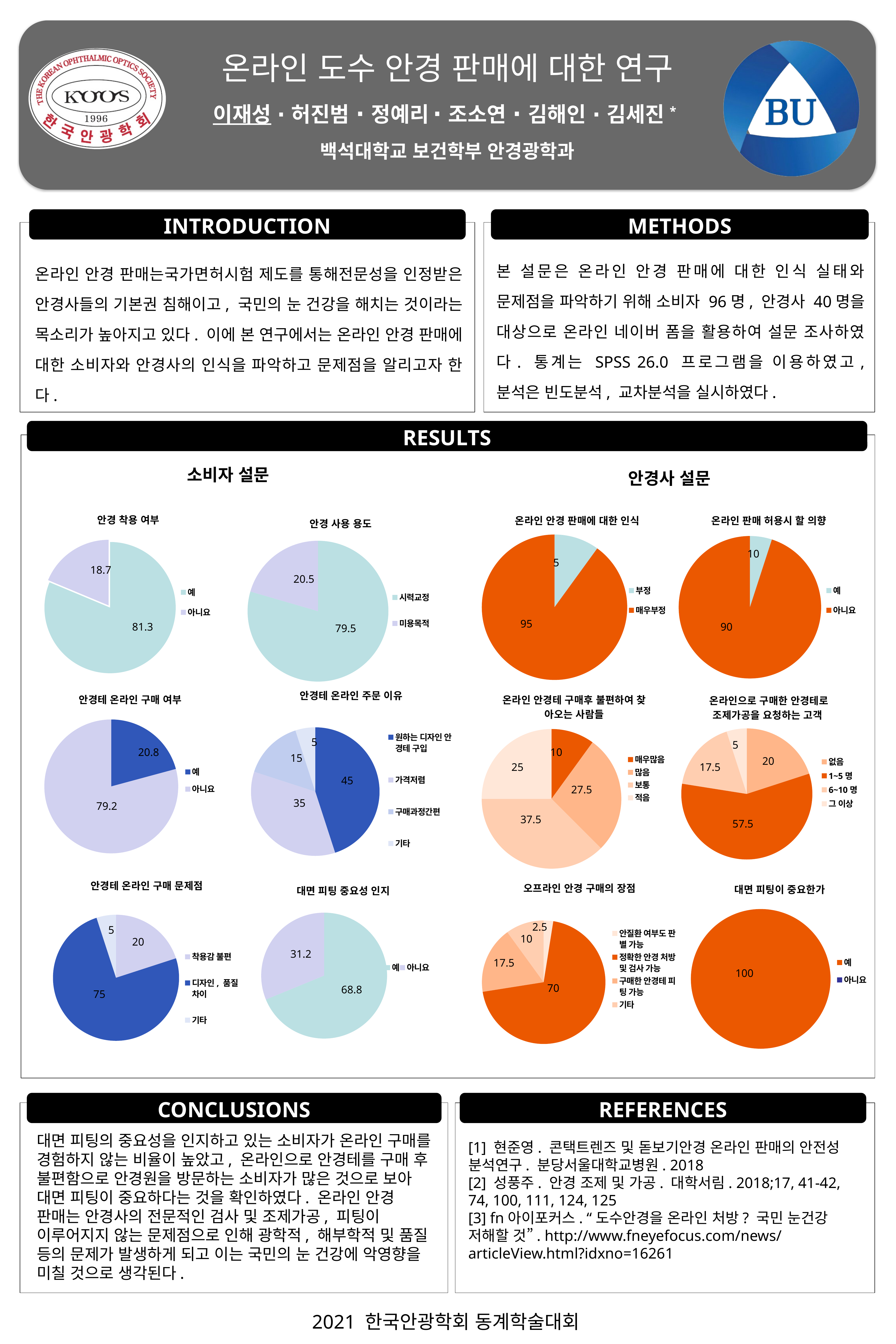
In the '온라인 판매 허용시 할 의향' pie chart, what is the difference between 아니요 and 예? 80 In the '온라인으로 구매한 안경테로 조제가공을 요청하는 고객' pie chart, what is the value for 1~5 명? 57.5 In the '안경테 온라인 구매 여부' pie chart, which is larger, 예 or 아니요? 아니요 In the '오프라인 안경 구매의 장점' pie chart, what is the value for 기타? 10 In the '안경 사용 용도' pie chart, what is the value for 미용목적? 20.5 In the '안경 착용 여부' pie chart, what is the value for 예? 81.3 In the '온라인 안경테 구매후 불편하여 찾아오는 사람들' pie chart, which category has the smallest slice? 매우많음 What type of chart is '대면 피팅 중요성 인지'? Pie chart In the '온라인 안경 판매에 대한 인식' pie chart, which category has the largest slice? 매우부정 In the '안경테 온라인 구매 문제점' pie chart, what is the value for 디자인, 품질 차이? 75 How many categories does the '안경테 온라인 주문 이유' pie chart show? 4 In the '대면 피팅이 중요한가' pie chart, what is the value for 예? 100